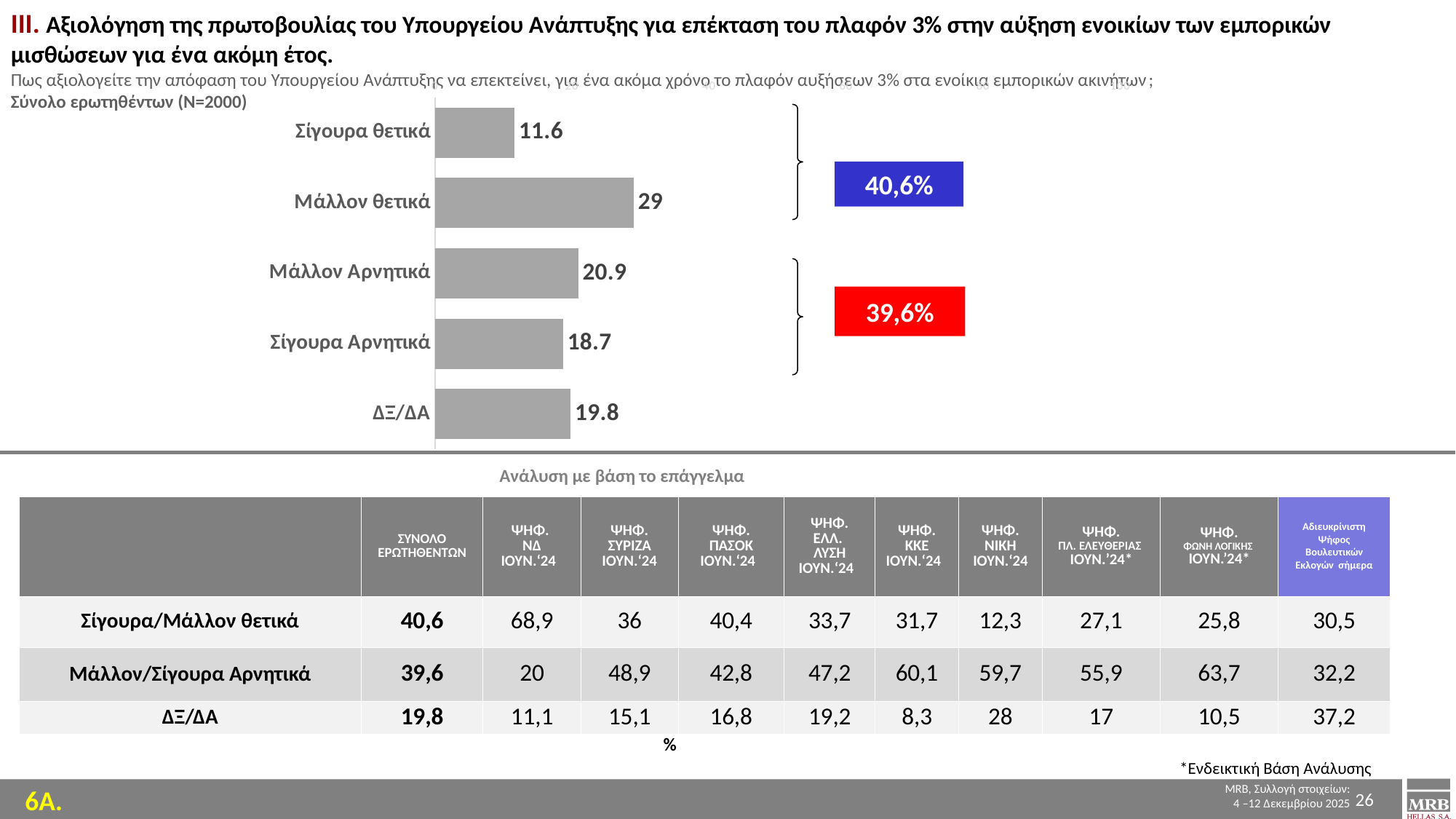
What is the difference between the values for Μάλλον Αρνητικά and Σίγουρα Αρνητικά? 2.2 What value is shown for Σίγουρα Αρνητικά in the bar chart? 18.7 Which category has the highest value in the bar chart? Μάλλον θετικά What is the difference between the values for Μάλλον θετικά and Σίγουρα θετικά? 17.4 What value is shown for Μάλλον θετικά in the bar chart? 29 What percentage is shown in the blue box next to the positive categories? 40,6% What kind of chart is shown on the slide? Bar chart Which category has the lowest value in the bar chart? Σίγουρα θετικά Which is larger, the value for Μάλλον Αρνητικά or the value for ΔΞ/ΔΑ? Μάλλον Αρνητικά How many categories are shown in the bar chart? 5 What value is shown for Σίγουρα θετικά in the bar chart? 11.6 What value is shown for ΔΞ/ΔΑ in the bar chart? 19.8